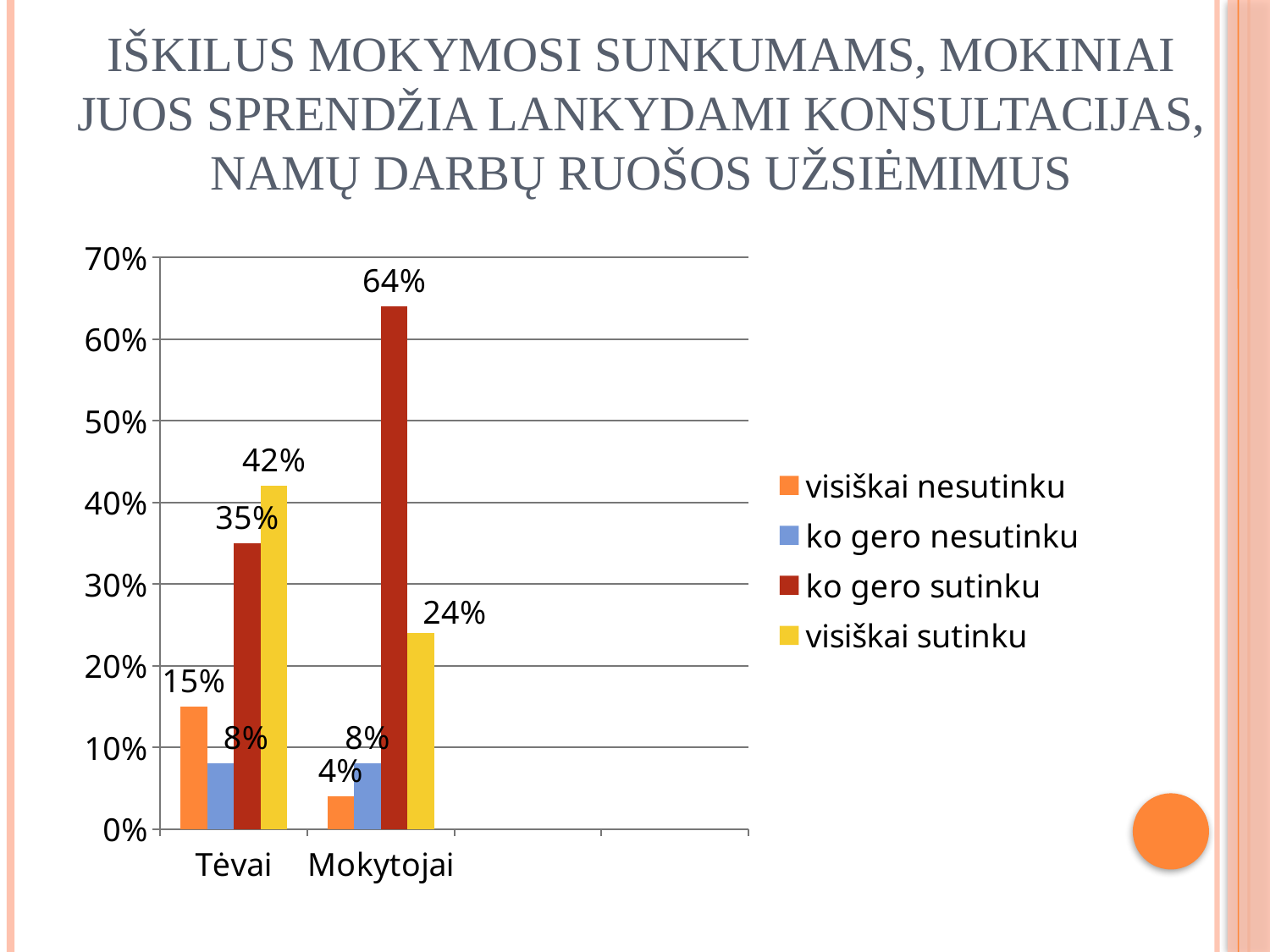
What is the difference between the "ko gero sutinku" values for Mokytojai and Tėvai? 29% What is the value for "visiškai nesutinku" in the Mokytojai category? 4% What is the value for "ko gero sutinku" in the Mokytojai category? 64% What is the value for "ko gero sutinku" in the Tėvai category? 35% How many series does the legend list? 4 Which series has the lowest value in the Tėvai category? ko gero nesutinku What kind of chart is shown on the slide? bar chart How many categories are shown on the x axis? 2 What colour represents the "visiškai sutinku" series? yellow What is the value for "visiškai sutinku" in the Tėvai category? 42% Which series has the highest value in the Mokytojai category? ko gero sutinku Which is larger: "visiškai sutinku" for Tėvai or "visiškai sutinku" for Mokytojai? Tėvai